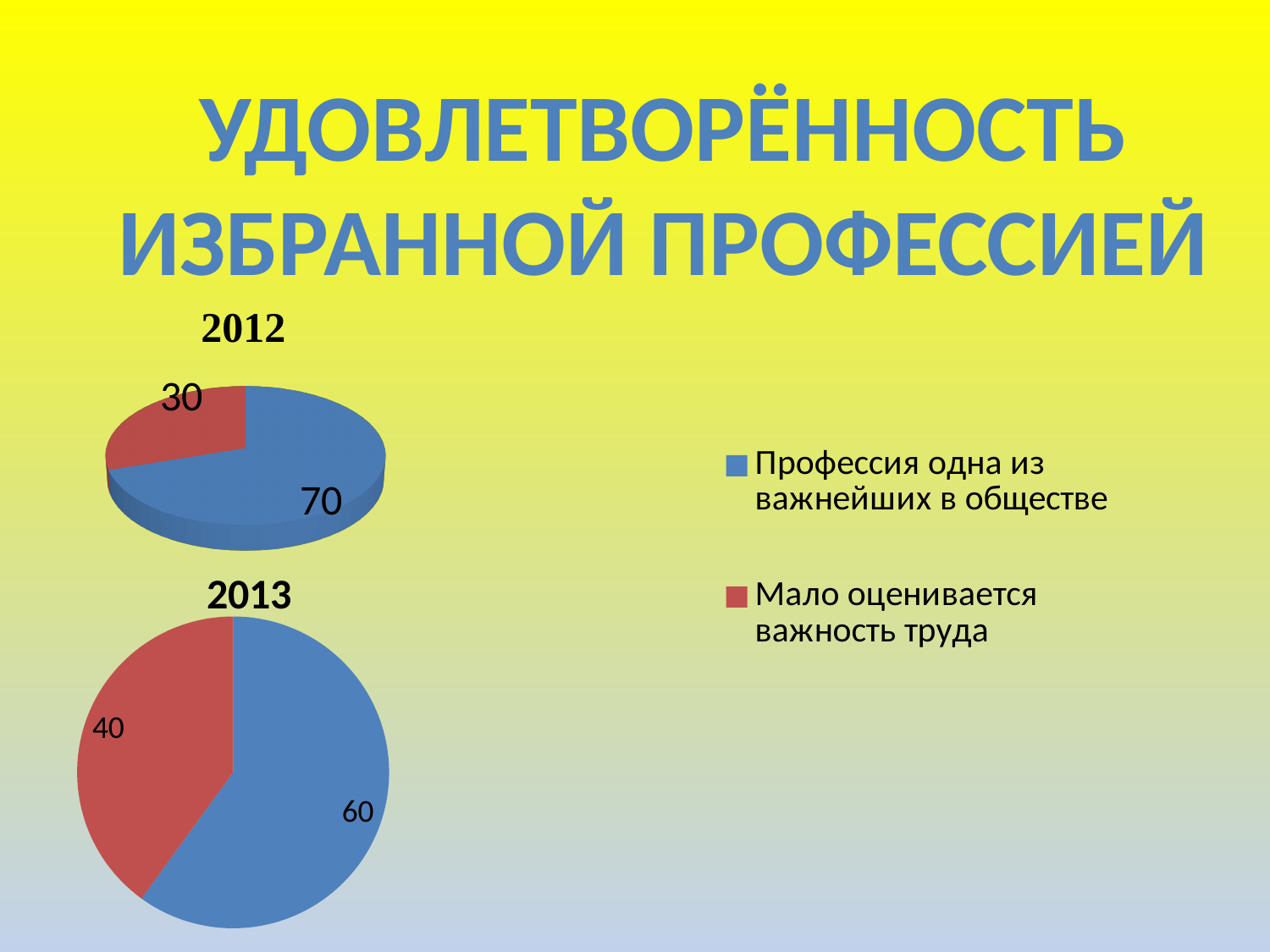
What type of chart is the 2013 chart? Pie chart In the 2013 pie chart, what is the value for "Мало оценивается важность труда"? 40 How many slices does the 2012 pie chart have? 2 In the 2012 pie chart, what is the value for "Мало оценивается важность труда"? 30 Is the value for "Мало оценивается важность труда" larger in the 2012 chart or the 2013 chart? 2013 In the 2012 pie chart, what is the difference between the two slice values? 40 In the 2012 pie chart, which category has the largest slice? Профессия одна из важнейших в обществе In the 2013 pie chart, what is the value for "Профессия одна из важнейших в обществе"? 60 Which colour represents "Мало оценивается важность труда" in the legend? Red In the 2012 pie chart, what is the value for "Профессия одна из важнейших в обществе"? 70 In the 2013 pie chart, what is the difference between the two slice values? 20 In the 2013 pie chart, which category has the smallest slice? Мало оценивается важность труда